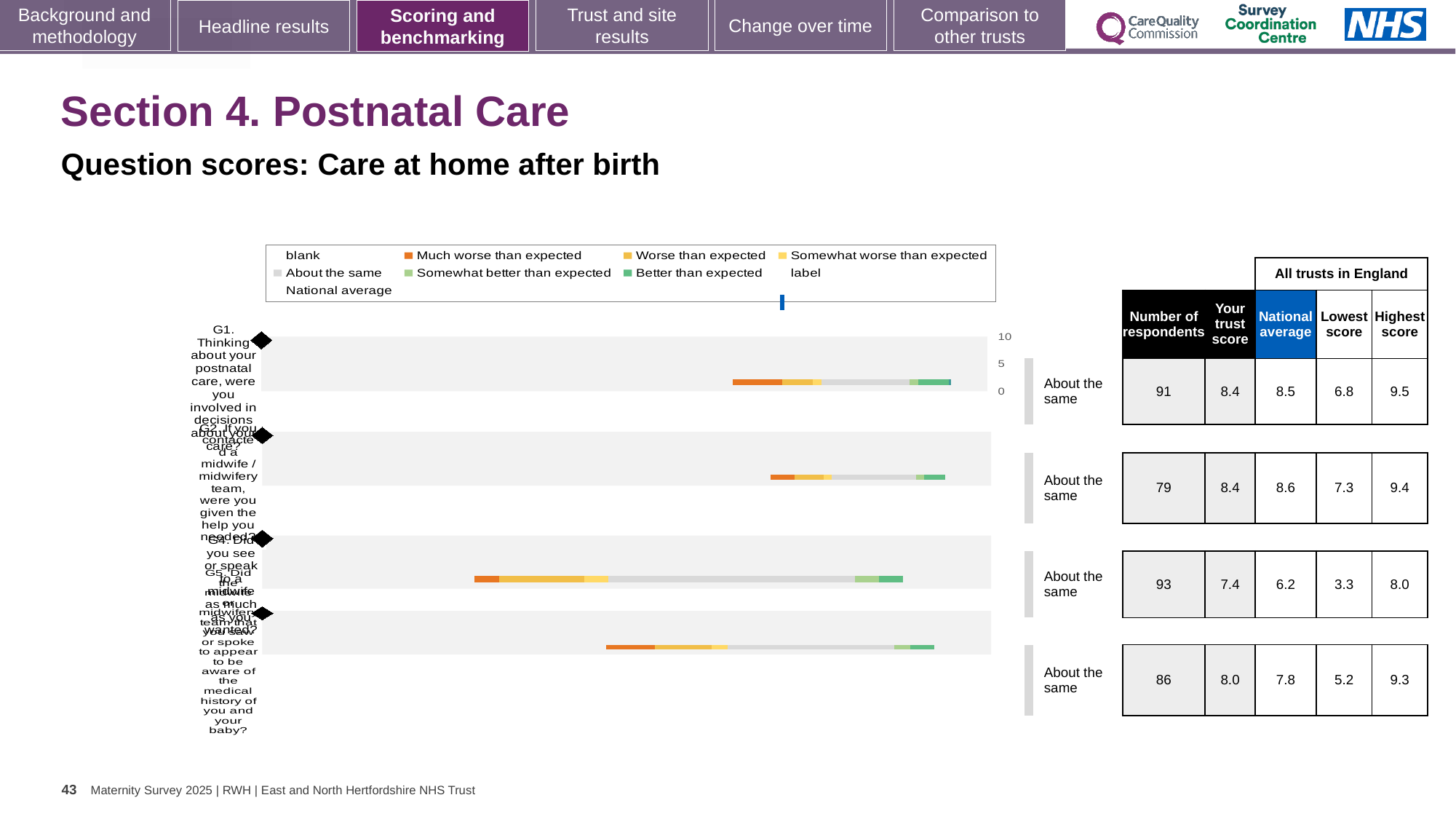
For question G1, which is larger: the trust score or the national average? National average (8.5) Which question row has the highest number of respondents? G4 (third row), 93 What is the difference between the highest score and the lowest score for question G1? 2.7 What is the national average for question G2 (If you contacted a midwife / midwifery team, were you given the help you needed?)? 8.6 What is the number of respondents for question G1 (Thinking about your postnatal care, were you involved in decisions about your care?)? 91 What is the trust score for question G1? 8.4 What kind of chart is shown on the slide? bar chart Which question row has the lowest trust score? G4 (third row), 7.4 What benchmark category is shown next to the bar for question G1? About the same How many question bars are plotted in the chart? 4 What is the lowest score across all trusts in England for the third question row (G4)? 3.3 What is the highest score across all trusts in England for the fourth question row (G5)? 9.3